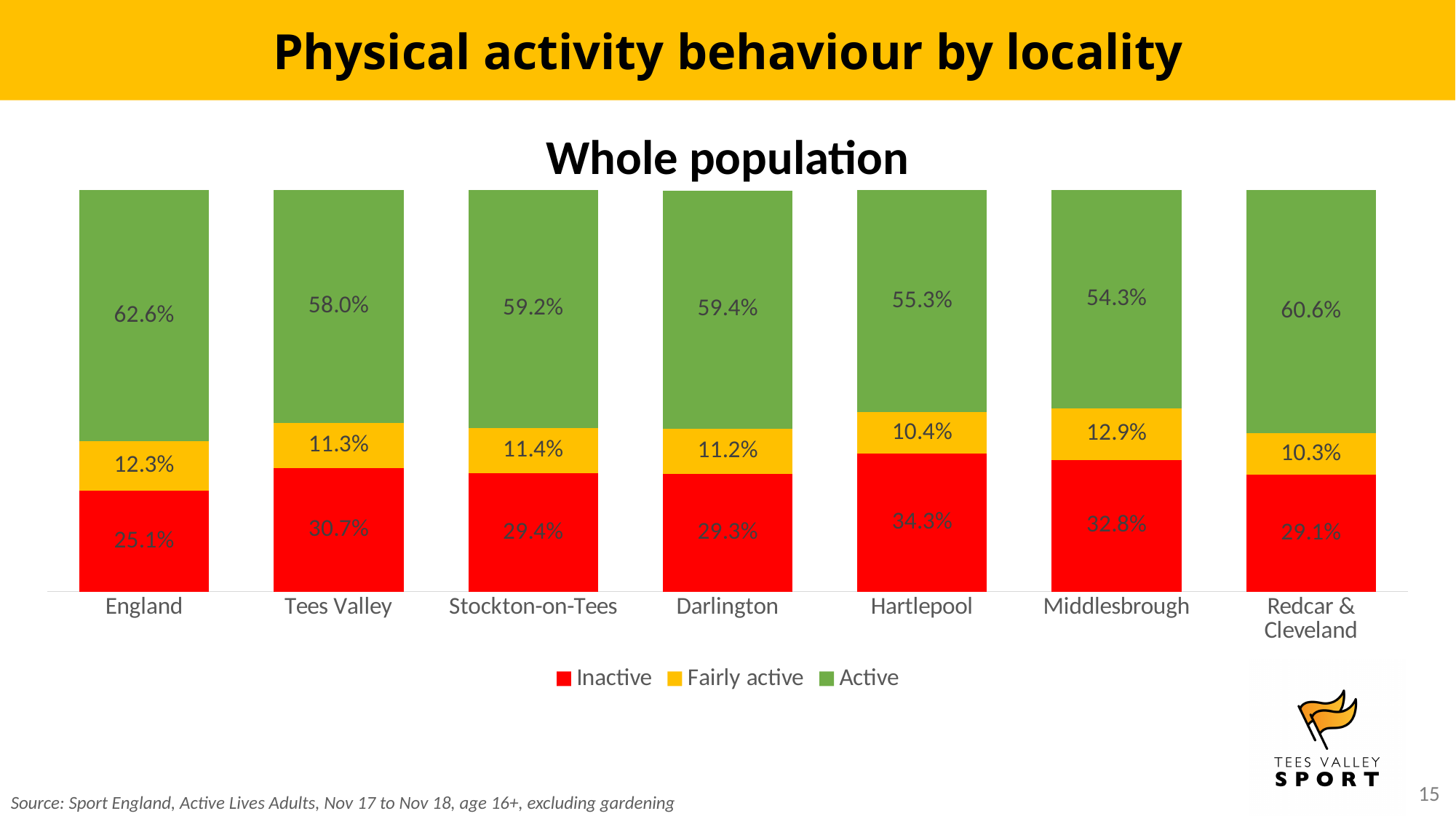
Which locality has the highest Inactive percentage? Hartlepool What percentage of the whole population in Hartlepool is Inactive? 34.3% Which locality has the highest Active percentage? England How many series does the legend list? 3 How many percentage points higher is the Inactive share in Hartlepool than in England? 9.2 What is the Active percentage for Redcar & Cleveland? 60.6% Which locality has the lowest Active percentage? Middlesbrough What is the Fairly active percentage for Tees Valley? 11.3% Which locality has the lowest Fairly active percentage? Redcar & Cleveland What type of chart is shown on the slide? Stacked bar chart How many localities are shown on the x axis? 7 Which has a larger Active percentage, Stockton-on-Tees or Darlington? Darlington